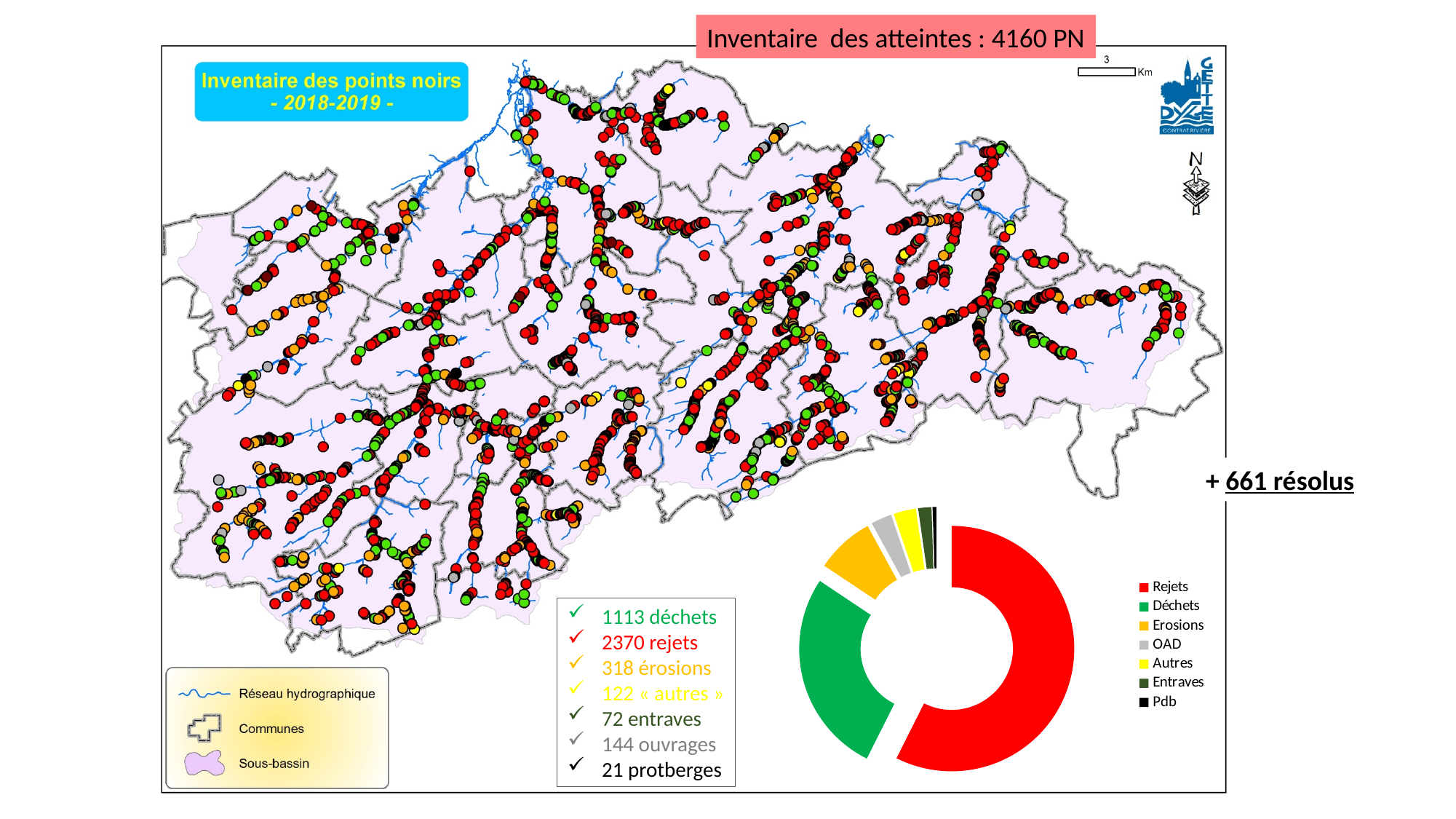
According to the slide, how many 'déchets' were inventoried? 1113 What kind of chart is shown at the bottom right of the slide? pie chart (donut) Which category has the smallest slice in the donut chart? Pdb Which slice is larger in the donut chart, Erosions or Autres? Erosions How many categories does the legend of the donut chart list? 7 What is the total number of points noirs (PN) given in the slide title? 4160 PN What colour represents Rejets in the donut chart? red Which slice is larger in the donut chart, Déchets or Erosions? Déchets According to the slide, how many 'érosions' were inventoried? 318 Which category has the largest slice in the donut chart? Rejets According to the slide, how many 'rejets' were inventoried? 2370 What is the difference between the number of rejets and the number of déchets listed on the slide? 1257